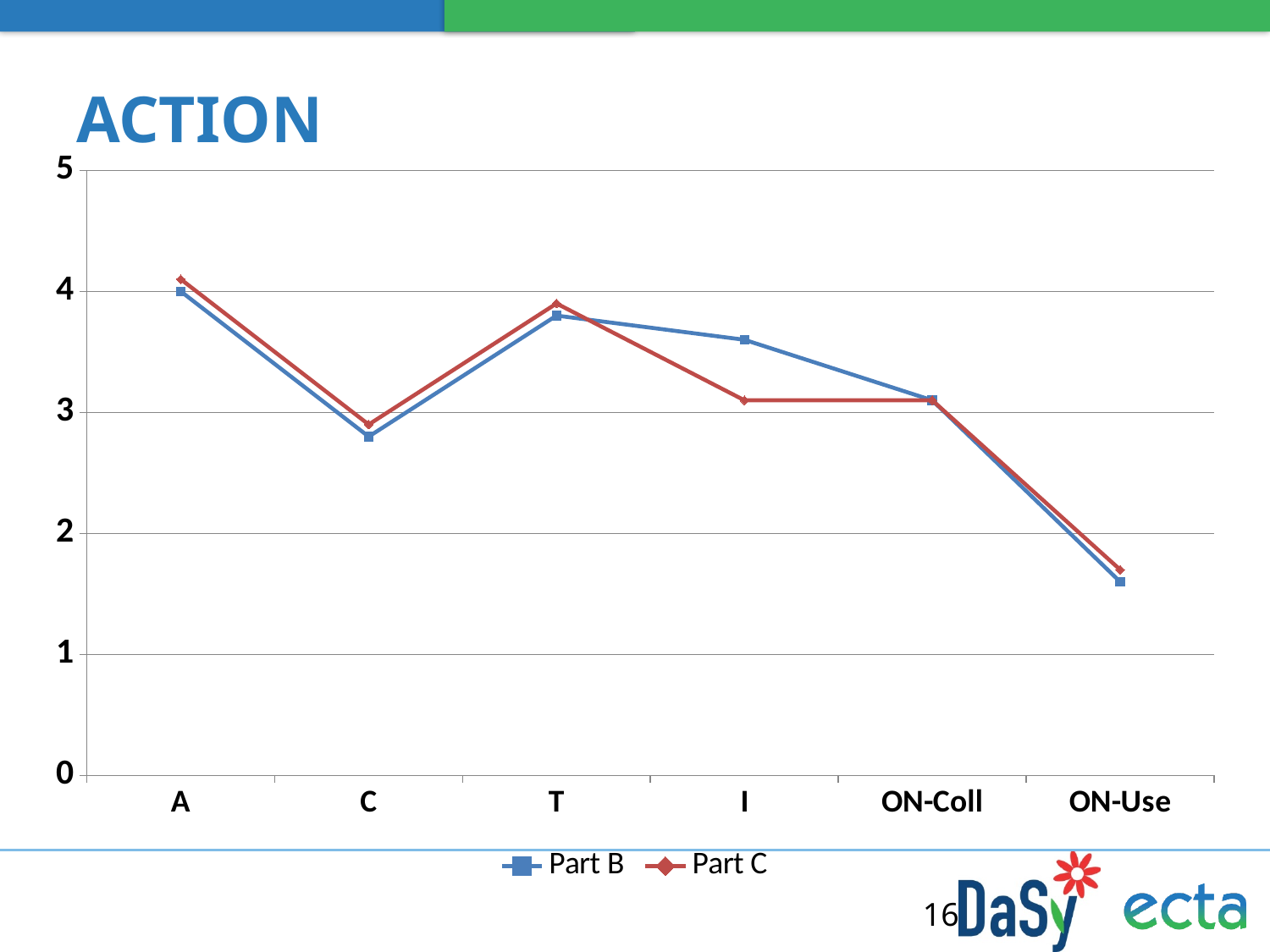
Which series is drawn in red? Part C How many series does the legend list? 2 Is the Part C value for ON-Use greater or less than 2? less Do the Part B values rise or fall from ON-Coll to ON-Use? fall At category I, which series has the larger value, Part B or Part C? Part B For which category is the Part C value lowest? ON-Use What kind of chart is shown on the slide? line chart For which category is the Part C value highest? A What is the title of the chart? ACTION For which category is the Part B value lowest? ON-Use Is the Part B value for C greater or less than 3? less How many categories are shown on the x axis? 6